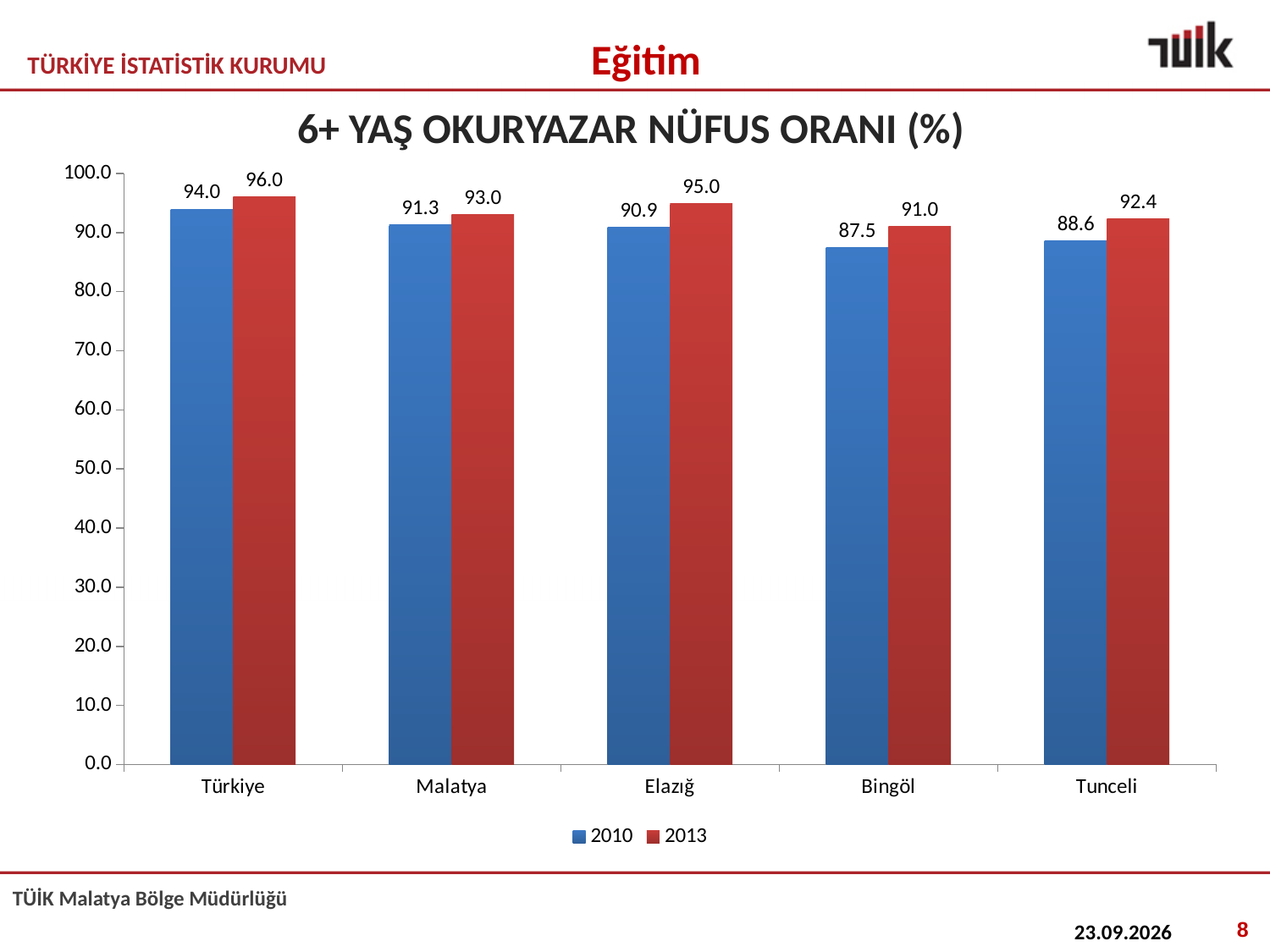
What kind of chart is shown on the slide? bar chart What is the title of the chart? 6+ YAŞ OKURYAZAR NÜFUS ORANI (%) Which category has the highest 2013 value? Türkiye What is the 2013 value for Malatya? 93.0 What is the difference between the 2010 values for Türkiye and Tunceli? 5.4 What is the difference between the 2013 and 2010 values for Elazığ? 4.1 Which is larger, the 2010 value for Malatya or the 2010 value for Elazığ? Malatya Which category has the lowest 2010 value? Bingöl What is the 2010 value for Bingöl? 87.5 How many series does the legend list? 2 What is the 2013 value for Tunceli? 92.4 How many categories are shown on the x axis? 5